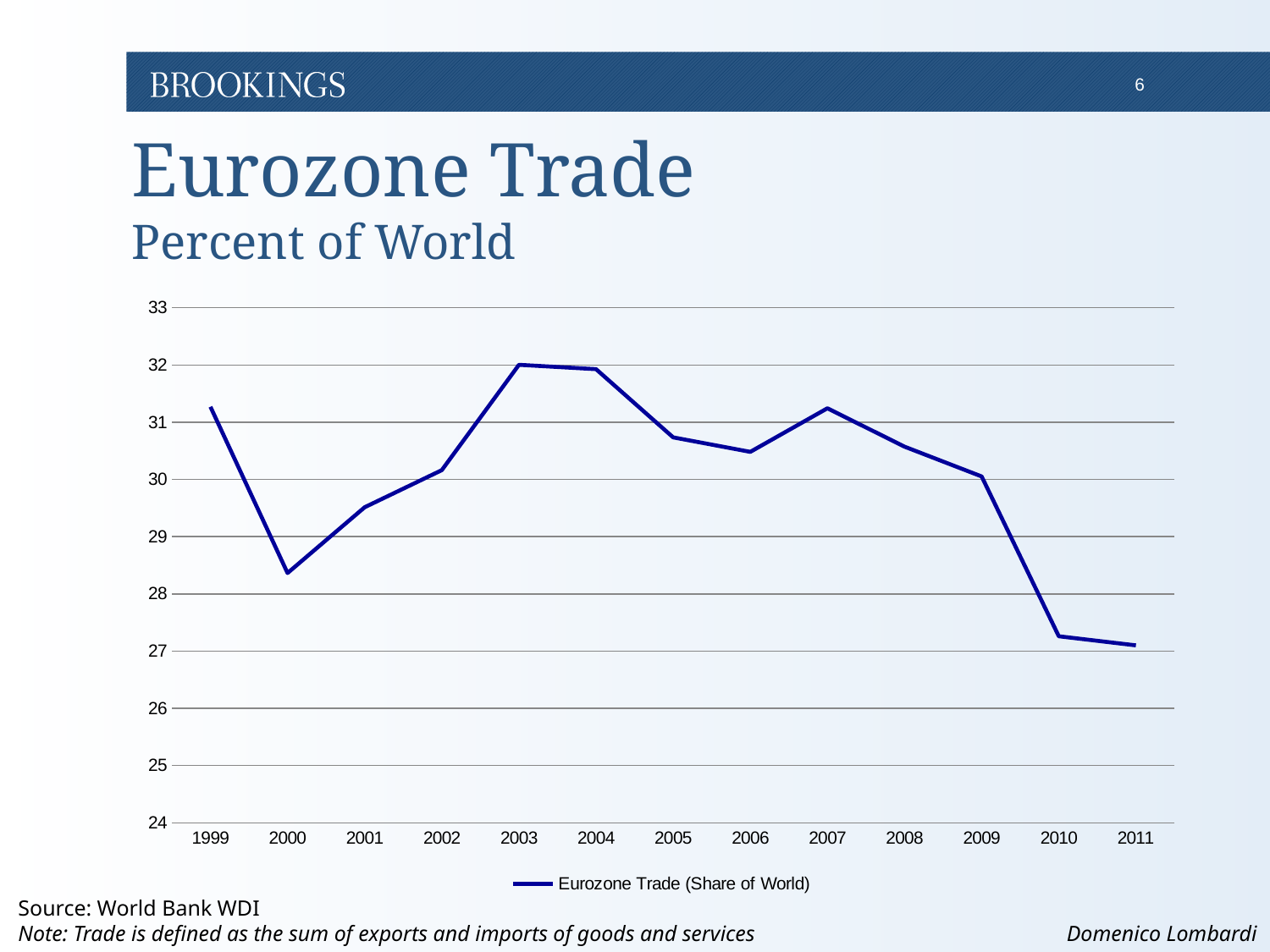
Is the value for 1999 greater or less than 31? greater Is the value for 2000 greater or less than 29? less Which year has the larger value, 2003 or 2011? 2003 What is the name of the series shown in the legend? Eurozone Trade (Share of World) Which year has the larger value, 2000 or 2007? 2007 Does the Eurozone trade share rise or fall between 2009 and 2011? fall How many years are plotted on the x axis of the chart? 13 How many series does the chart's legend list? 1 Is the value for 2003 greater or less than 31? greater What kind of chart is shown on the slide? line chart